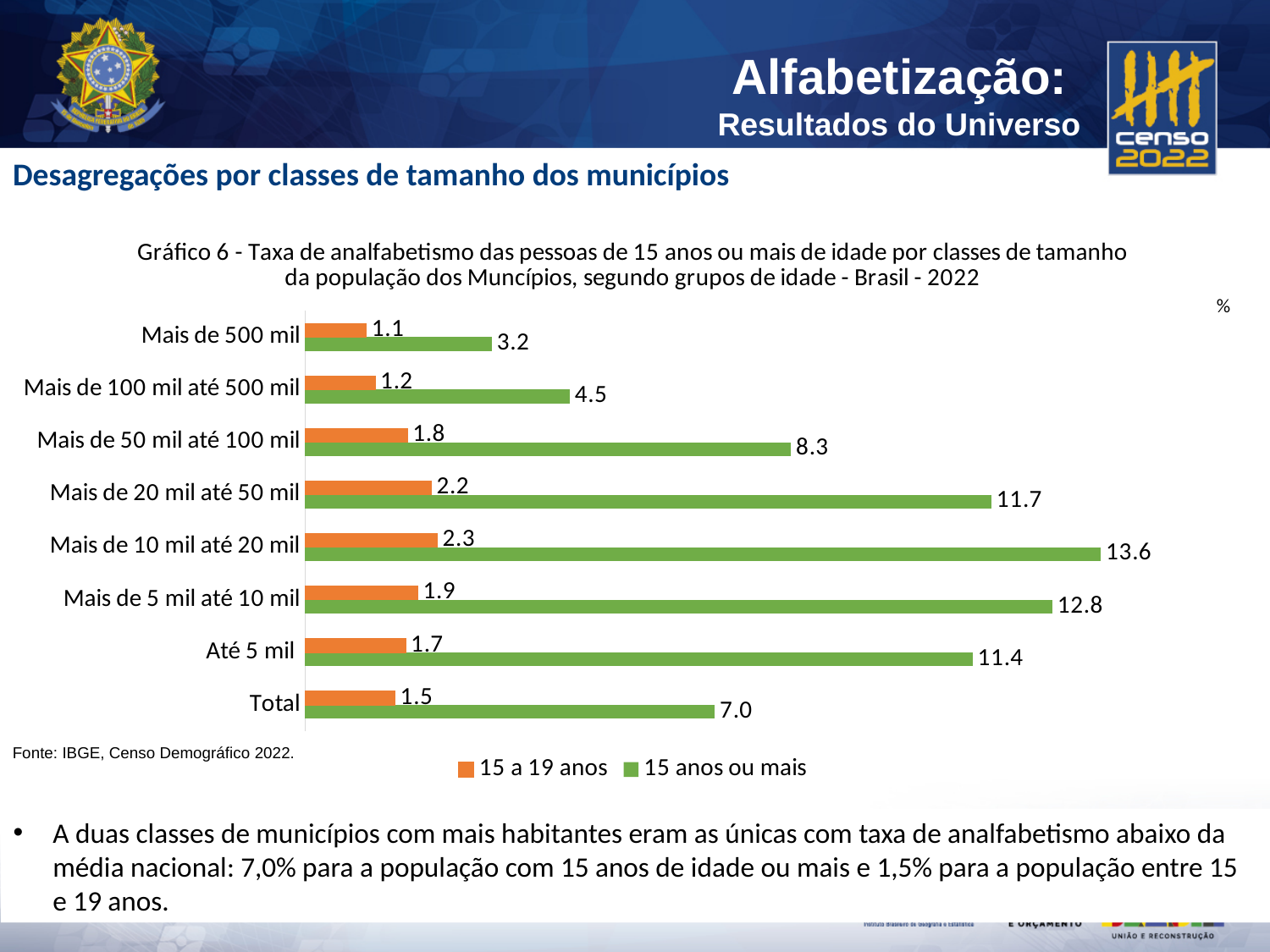
What type of chart is shown on the slide? Bar chart What is the difference between the '15 a 19 anos' values for 'Mais de 10 mil até 20 mil' and 'Total'? 0.8 Which is larger: the '15 anos ou mais' value for 'Até 5 mil' or for 'Mais de 50 mil até 100 mil'? Até 5 mil Which category has the lowest value for '15 a 19 anos'? Mais de 500 mil What is the value for '15 anos ou mais' in the category 'Mais de 10 mil até 20 mil'? 13.6 Which series is shown in orange in the chart? 15 a 19 anos What is the value for '15 a 19 anos' in the category 'Mais de 500 mil'? 1.1 How many series does the legend list? 2 How many categories are shown on the vertical axis of the chart? 8 What is the value for '15 anos ou mais' in the 'Total' category? 7.0 What is the difference between the '15 anos ou mais' values for 'Mais de 5 mil até 10 mil' and 'Mais de 500 mil'? 9.6 Which category has the highest value for '15 anos ou mais'? Mais de 10 mil até 20 mil